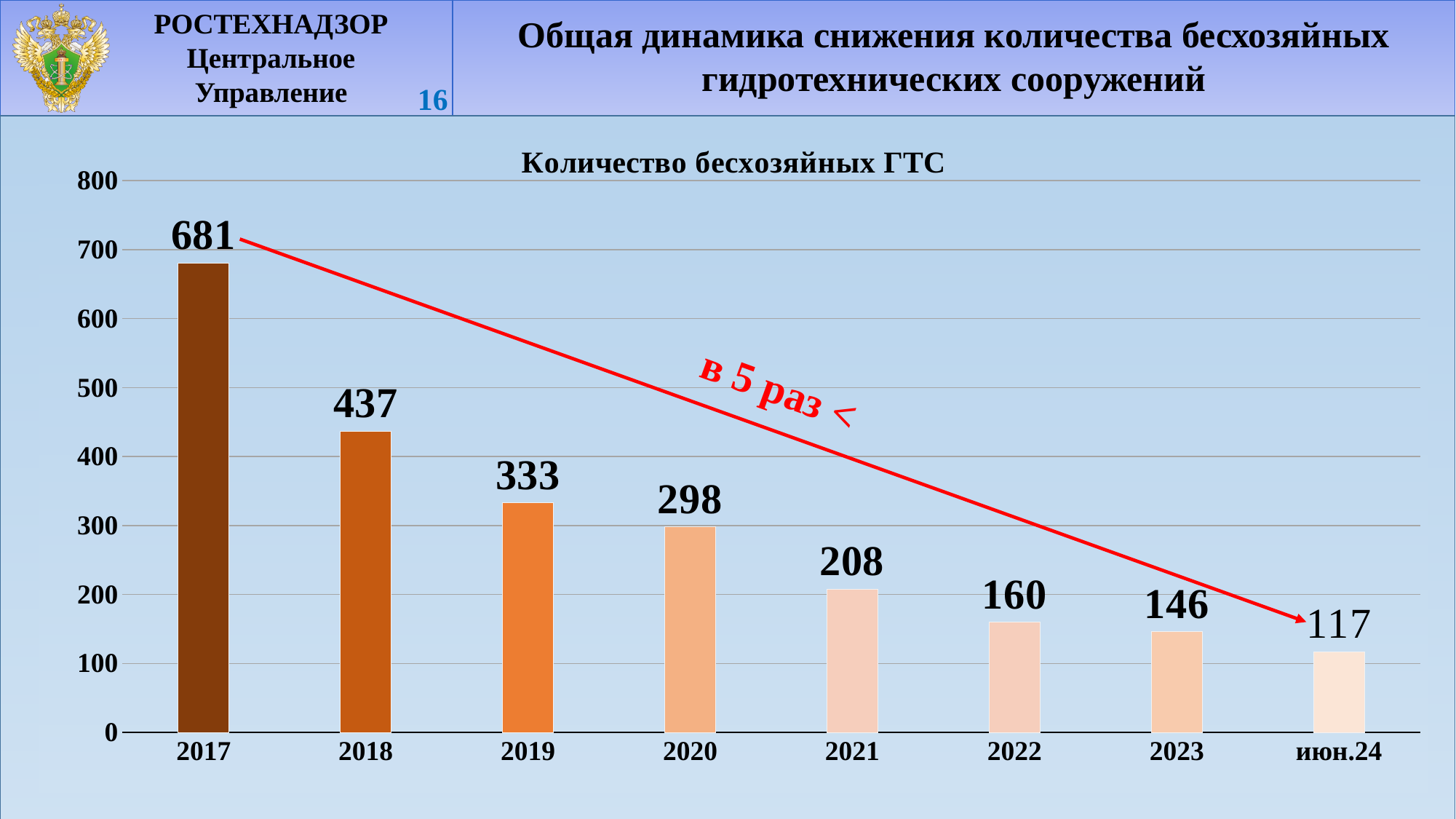
What is the value for 2017? 681 Do the values rise or fall from 2017 to июн.24? fall Which category has the lowest value? июн.24 What is the difference between the values for 2022 and 2023? 14 What is the value for 2020? 298 What kind of chart is shown on the slide? bar chart Which category has the highest value? 2017 How many categories are shown on the x axis? 8 Is the value for 2018 greater or less than 400? greater What is the difference between the values for 2017 and 2018? 244 What is the value for июн.24? 117 Which is larger, the value for 2019 or the value for 2021? 2019